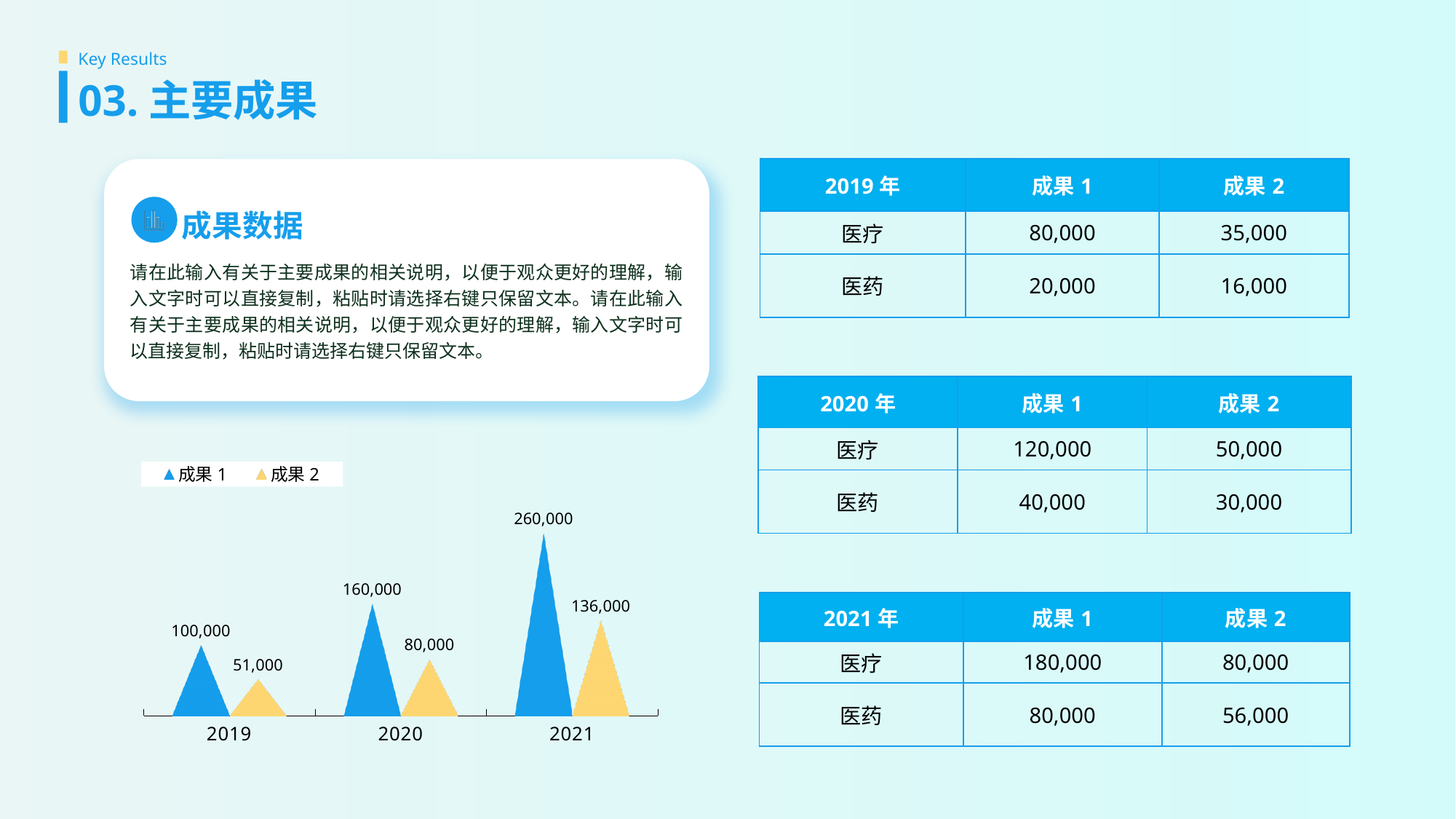
What is the value of 成果 2 for 2021 in the chart? 136,000 How many series does the chart legend list? 2 What is the value of 成果 1 for 2020 in the chart? 160,000 What is the value of 成果 1 for 2021 in the chart? 260,000 Which year has the highest value for 成果 1 in the chart? 2021 How many years are shown on the x axis of the chart? 3 What is the value of 成果 2 for 2019 in the chart? 51,000 What colour represents 成果 2 in the chart? yellow What is the difference between 成果 1 and 成果 2 in 2020 in the chart? 80,000 In the chart, which is larger in 2019: 成果 1 or 成果 2? 成果 1 Does the value of 成果 1 rise or fall from 2019 to 2021 in the chart? rise Which year has the lowest value for 成果 2 in the chart? 2019